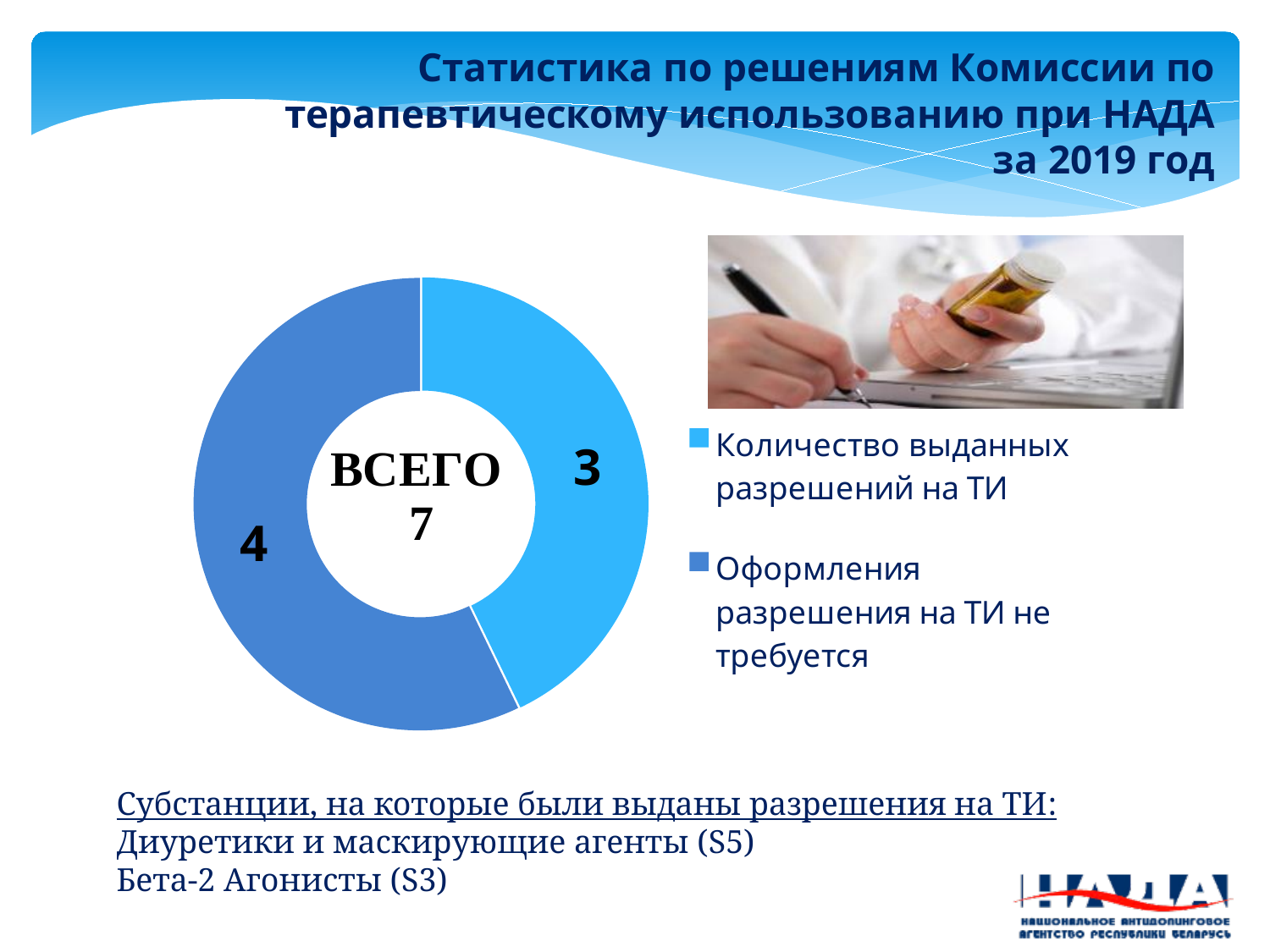
What word is written in the centre of the doughnut chart above the total? ВСЕГО What total is shown in the centre of the doughnut chart? 7 Is the value for "Количество выданных разрешений на ТИ" larger or smaller than the value for "Оформления разрешения на ТИ не требуется"? smaller What is the difference between the two slice values in the chart? 1 How many slices does the doughnut chart have? 2 What is the value for "Количество выданных разрешений на ТИ"? 3 Which category has the smaller slice in the chart? Количество выданных разрешений на ТИ How many entries does the legend of the chart list? 2 Which legend entry is shown in the lighter blue colour? Количество выданных разрешений на ТИ What is the value for "Оформления разрешения на ТИ не требуется"? 4 What kind of chart is shown on the slide? doughnut (pie) chart Which category has the larger slice in the chart? Оформления разрешения на ТИ не требуется